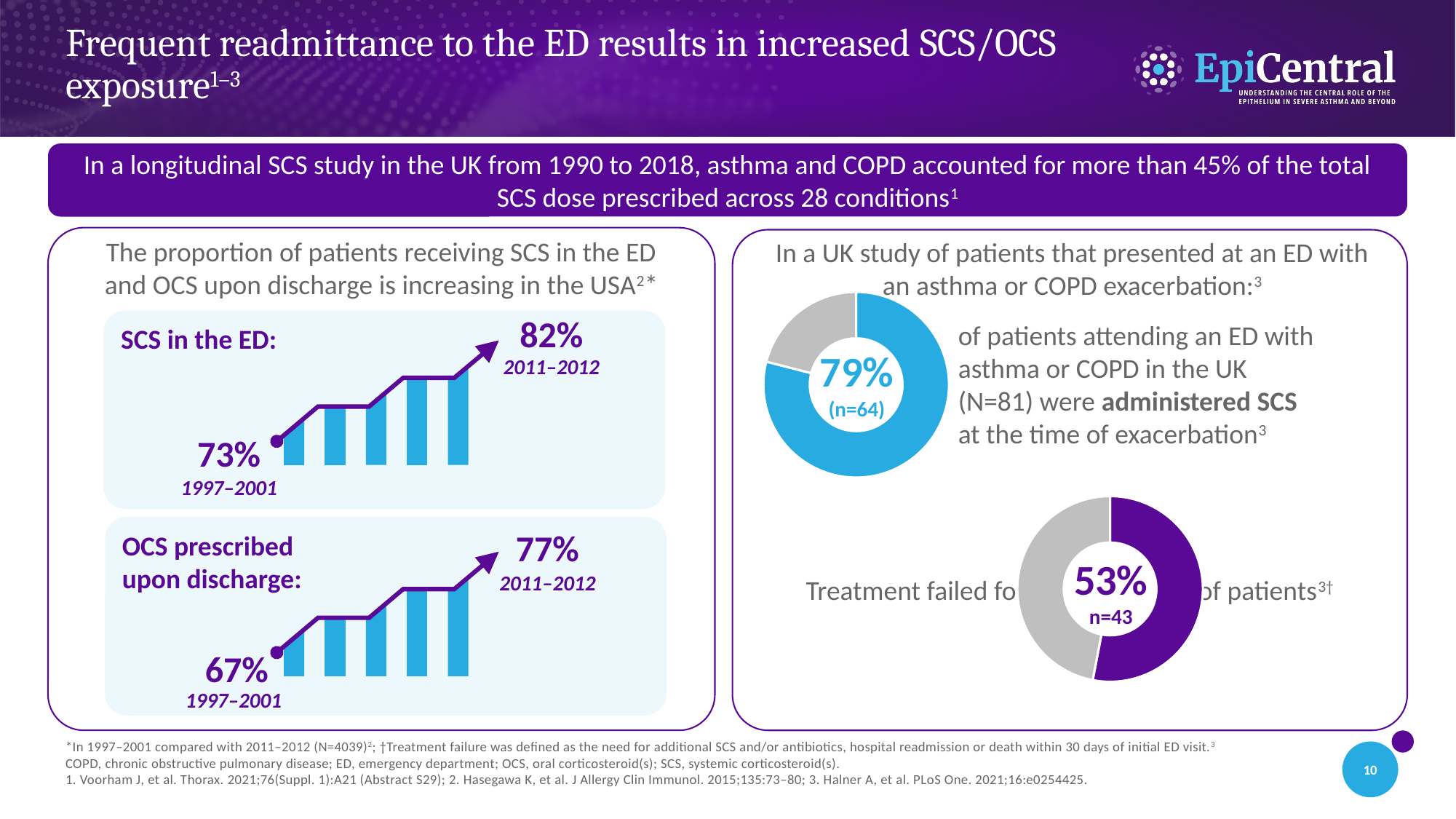
In the upper donut chart on the right, what percentage of patients attending an ED with asthma or COPD in the UK were administered SCS at the time of exacerbation? 79% In the 'SCS in the ED' chart, by how many percentage points did the value increase from 1997–2001 to 2011–2012? 9 percentage points In the 'SCS in the ED' chart, does the value rise or fall from 1997–2001 to 2011–2012? Rise What kind of chart is used to show the 53% treatment failure figure? Donut (pie) chart Which is larger for 2011–2012: the 'SCS in the ED' value or the 'OCS prescribed upon discharge' value? SCS in the ED (82%) In the 'OCS prescribed upon discharge' chart, what was the value for 2011–2012? 77% In the 'OCS prescribed upon discharge' chart, what was the value for 1997–2001? 67% In the 'SCS in the ED' chart, what was the value for 2011–2012? 82% In the lower donut chart on the right, for what percentage of patients did treatment fail? 53% In the upper donut chart on the right, how many patients does the 79% share correspond to? n=64 In the 'OCS prescribed upon discharge' chart, by how many percentage points did the value increase from 1997–2001 to 2011–2012? 10 percentage points In the 'SCS in the ED' chart, what was the value for 1997–2001? 73%